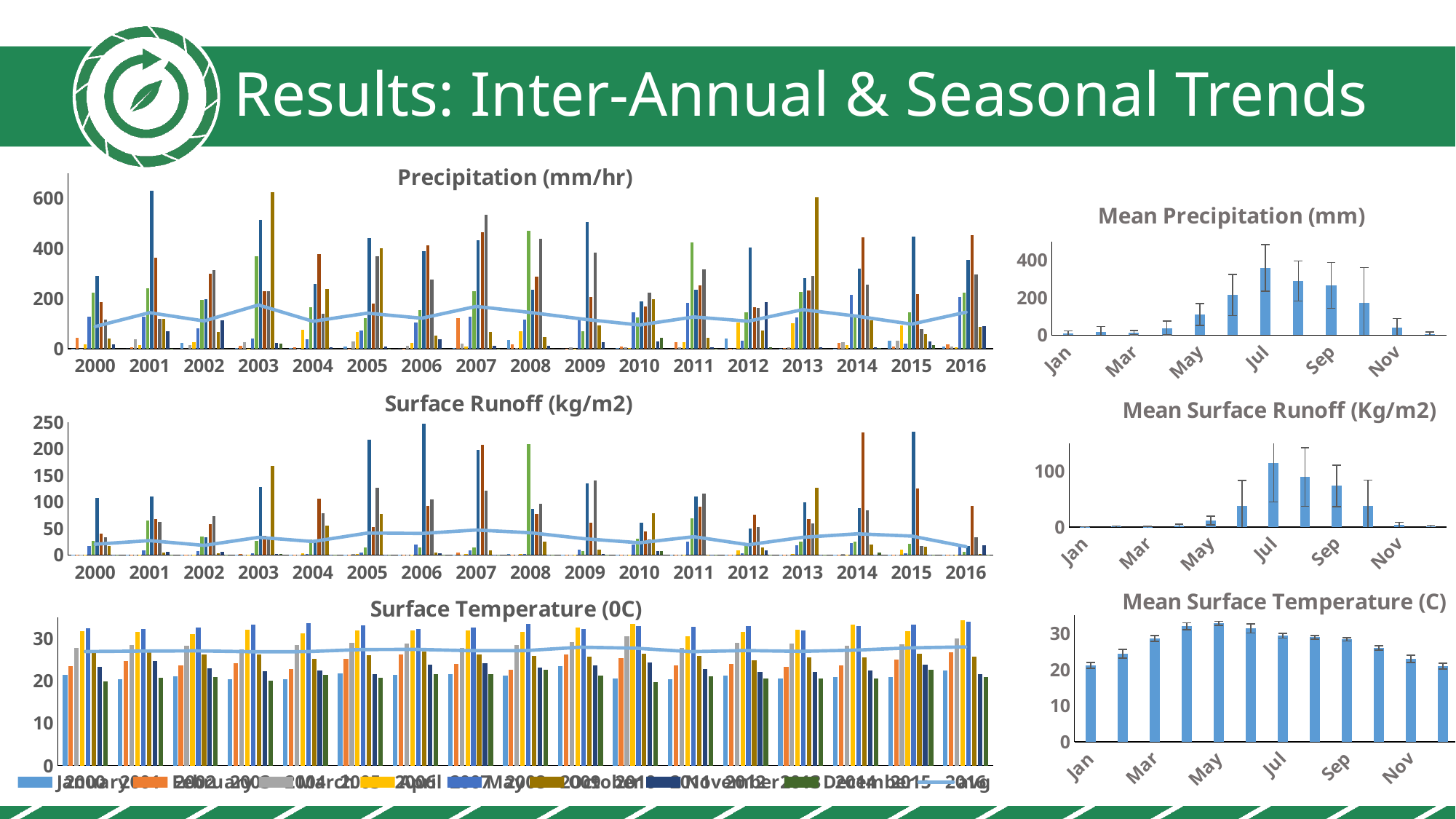
What kind of chart is the Mean Precipitation (mm) chart? bar chart In the Mean Surface Runoff (Kg/m2) chart, is the value for Sep greater or less than 100? less In the Mean Surface Runoff (Kg/m2) chart, which month has the highest mean surface runoff? Jul In the Mean Surface Runoff (Kg/m2) chart, is the value for Jul greater or less than 100? greater In the Mean Surface Temperature (C) chart, do the values rise or fall from Jan to May? rise In the Mean Precipitation (mm) chart, is the value for Jul greater or less than 200? greater In the Mean Surface Temperature (C) chart, how many monthly bars are plotted? 12 In the Precipitation (mm/hr) chart on the left, how many years are shown on the x axis? 17 In the Mean Precipitation (mm) chart, which month has the highest mean precipitation? Jul How many charts are shown on the slide? 6